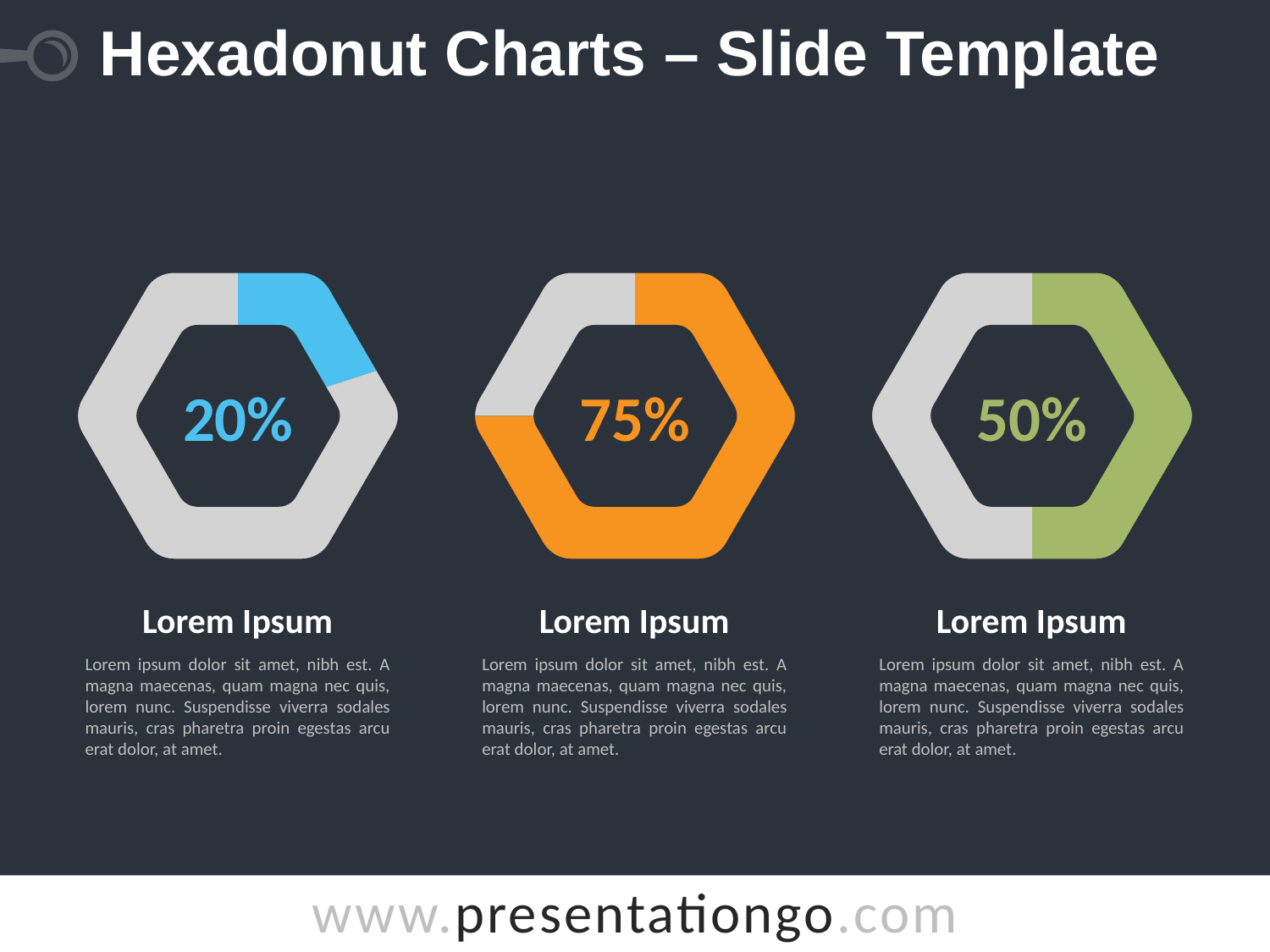
What value is shown in the right hexadonut chart? 50% What is the difference between the value in the middle hexadonut chart and the value in the right hexadonut chart? 25% What colour is the filled portion of the middle hexadonut chart? orange Which of the three hexadonut charts shows the lowest value: left, middle or right? left What value is shown in the middle hexadonut chart? 75% Which of the three hexadonut charts shows the highest value: left, middle or right? middle What is the difference between the value in the middle hexadonut chart and the value in the left hexadonut chart? 55% What colour is the filled portion of the left hexadonut chart? blue Which is larger, the value in the right hexadonut chart or the value in the left hexadonut chart? right How many hexadonut charts are on the slide? 3 What kind of chart is used on this slide? hexagonal donut chart What value is shown in the left hexadonut chart? 20%